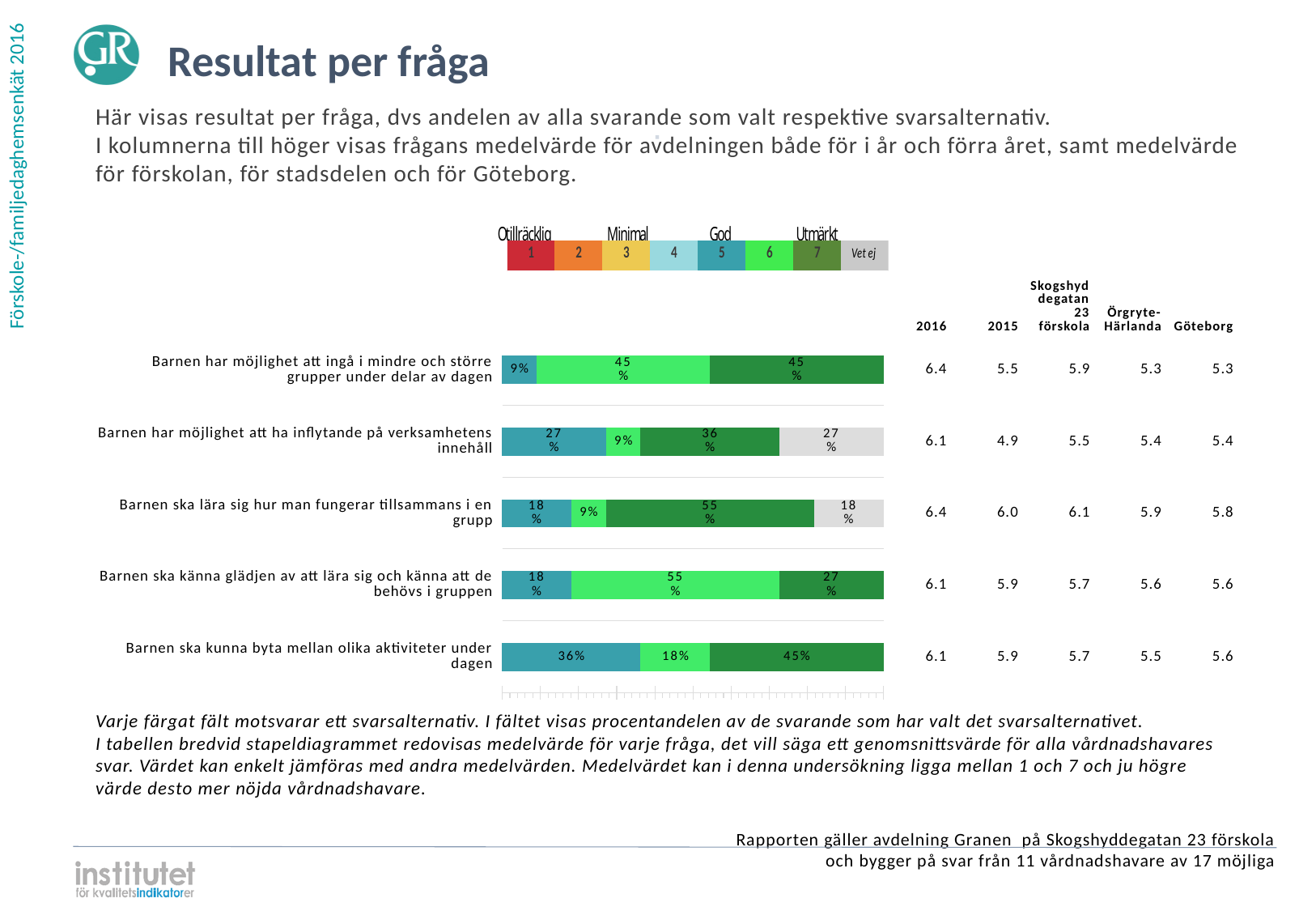
What percentage of respondents answered 'Vet ej' for 'Barnen har möjlighet att ha inflytande på verksamhetens innehåll'? 27% How many questions (bars) are plotted in the chart? 5 What percentage of respondents chose option 5 (teal) for 'Barnen ska kunna byta mellan olika aktiviteter under dagen'? 36% Which question has the largest share of respondents choosing option 5 (teal)? Barnen ska kunna byta mellan olika aktiviteter under dagen Is the option 7 (dark green) share larger for 'Barnen ska kunna byta mellan olika aktiviteter under dagen' or for 'Barnen ska känna glädjen av att lära sig och känna att de behövs i gruppen'? Barnen ska kunna byta mellan olika aktiviteter under dagen What kind of chart is shown on the slide? Stacked bar chart Which question has the smallest share of respondents choosing option 5 (teal)? Barnen har möjlighet att ingå i mindre och större grupper under delar av dagen How many answer options does the legend above the chart list? 8 What is the title of the slide containing the chart? Resultat per fråga What percentage of respondents chose option 7 (dark green) for 'Barnen ska lära sig hur man fungerar tillsammans i en grupp'? 55% For 'Barnen har möjlighet att ingå i mindre och större grupper under delar av dagen', what is the difference between the option 6 share and the option 5 share? 36 percentage points What percentage of respondents chose option 6 (light green) for 'Barnen ska känna glädjen av att lära sig och känna att de behövs i gruppen'? 55%